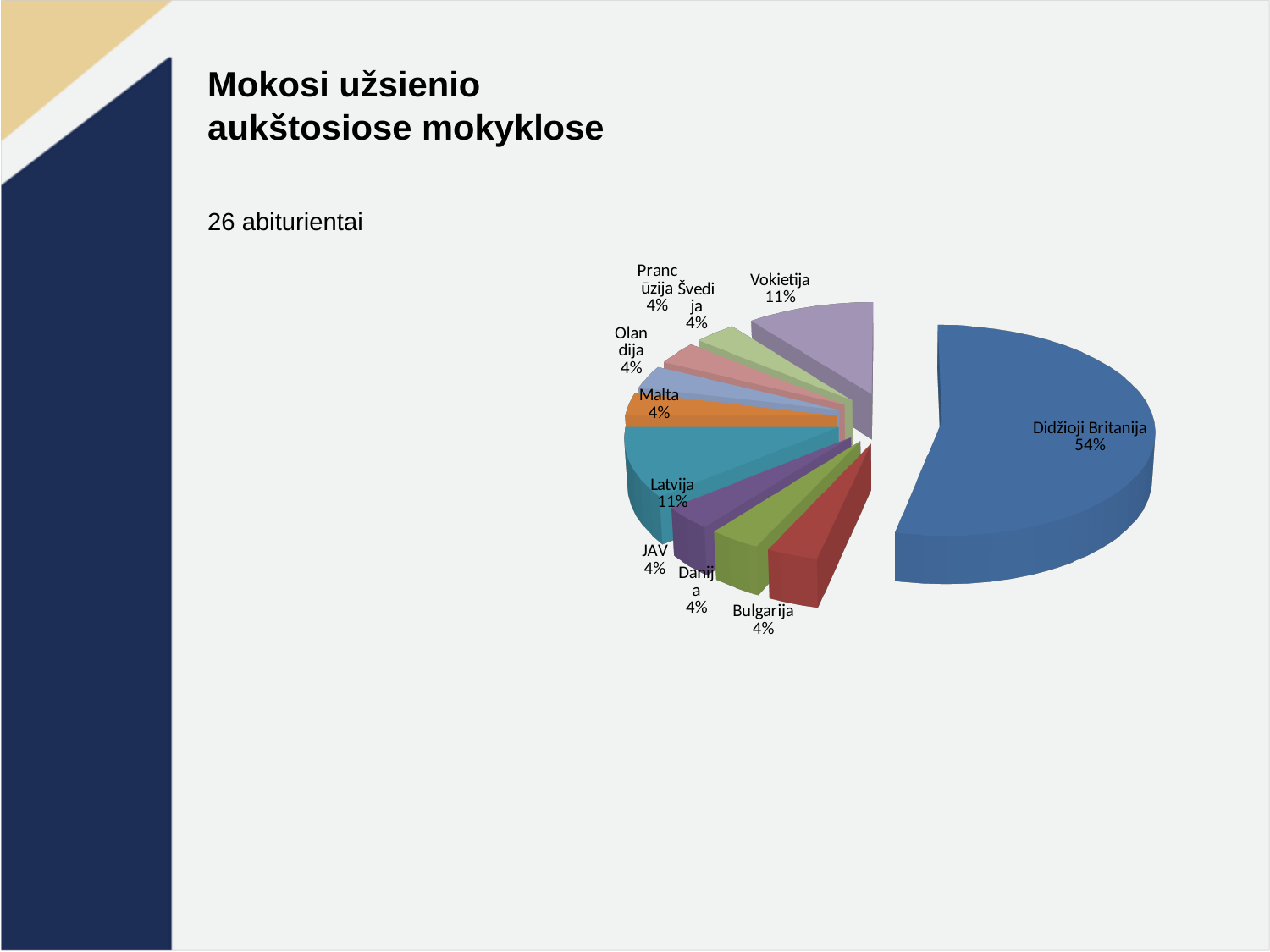
Which is larger, the share for Latvija or the share for JAV? Latvija How many slices does the pie chart have? 10 What share of the pie does Vokietija hold? 11% What share of the pie does Bulgarija hold? 4% What share of the pie does Didžioji Britanija hold? 54% What kind of chart is shown on the slide? pie chart What is the difference in percentage points between Didžioji Britanija and Vokietija? 43 Which country has the largest slice of the pie? Didžioji Britanija What is the title of the slide containing the chart? Mokosi užsienio aukštosiose mokyklose What is the difference in percentage points between Latvija and Danija? 7